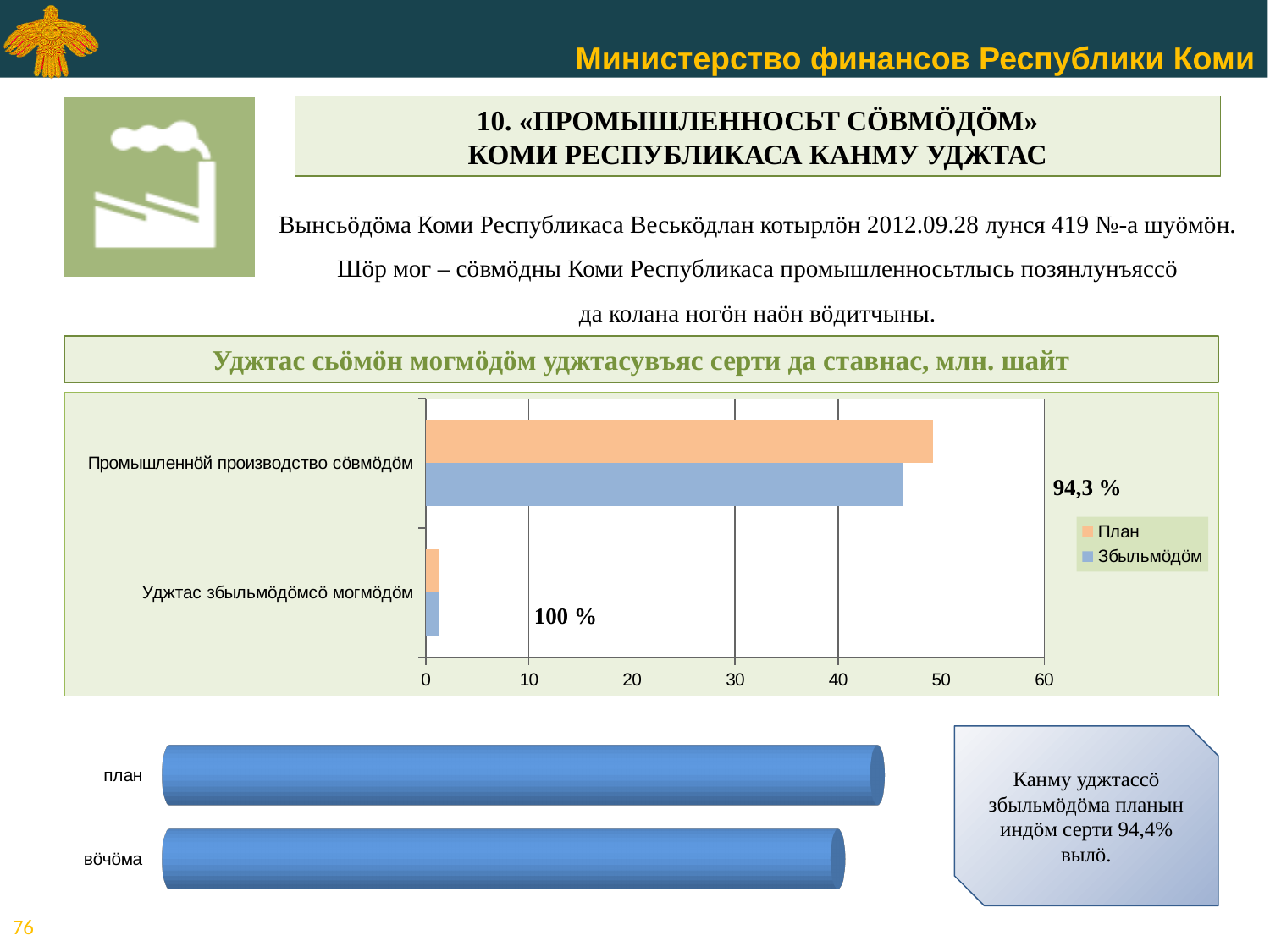
In the chart titled «Уджтас сьӧмӧн могмӧдӧм уджтасувъяс серти да ставнас, млн. шайт», is the План value for «Уджтас збыльмӧдӧмсӧ могмӧдӧм» greater or less than 10? less In the chart titled «Уджтас сьӧмӧн могмӧдӧм уджтасувъяс серти да ставнас, млн. шайт», which category has the larger План value? Промышленнӧй производство сӧвмӧдӧм What kind of chart is the chart titled «Уджтас сьӧмӧн могмӧдӧм уджтасувъяс серти да ставнас, млн. шайт»? bar chart In the chart titled «Уджтас сьӧмӧн могмӧдӧм уджтасувъяс серти да ставнас, млн. шайт», what percentage label is shown next to the bars for «Промышленнӧй производство сӧвмӧдӧм»? 94,3 % In the chart at the bottom of the slide with the categories «план» and «вӧчӧма», which bar is longer? план In the chart titled «Уджтас сьӧмӧн могмӧдӧм уджтасувъяс серти да ставнас, млн. шайт», how many series does the legend list? 2 In the chart titled «Уджтас сьӧмӧн могмӧдӧм уджтасувъяс серти да ставнас, млн. шайт», is the Збыльмӧдӧм value for «Промышленнӧй производство сӧвмӧдӧм» greater or less than 50? less In the chart titled «Уджтас сьӧмӧн могмӧдӧм уджтасувъяс серти да ставнас, млн. шайт», what percentage label is shown next to the bars for «Уджтас збыльмӧдӧмсӧ могмӧдӧм»? 100 % In the chart titled «Уджтас сьӧмӧн могмӧдӧм уджтасувъяс серти да ставнас, млн. шайт», how many categories are shown on the vertical axis? 2 In the chart titled «Уджтас сьӧмӧн могмӧдӧм уджтасувъяс серти да ставнас, млн. шайт», is the План value for «Промышленнӧй производство сӧвмӧдӧм» greater or less than 40? greater In the chart titled «Уджтас сьӧмӧн могмӧдӧм уджтасувъяс серти да ставнас, млн. шайт», for «Промышленнӧй производство сӧвмӧдӧм», which series has the larger value, План or Збыльмӧдӧм? План In the chart titled «Уджтас сьӧмӧн могмӧдӧм уджтасувъяс серти да ставнас, млн. шайт», what are the two legend entries? План, Збыльмӧдӧм